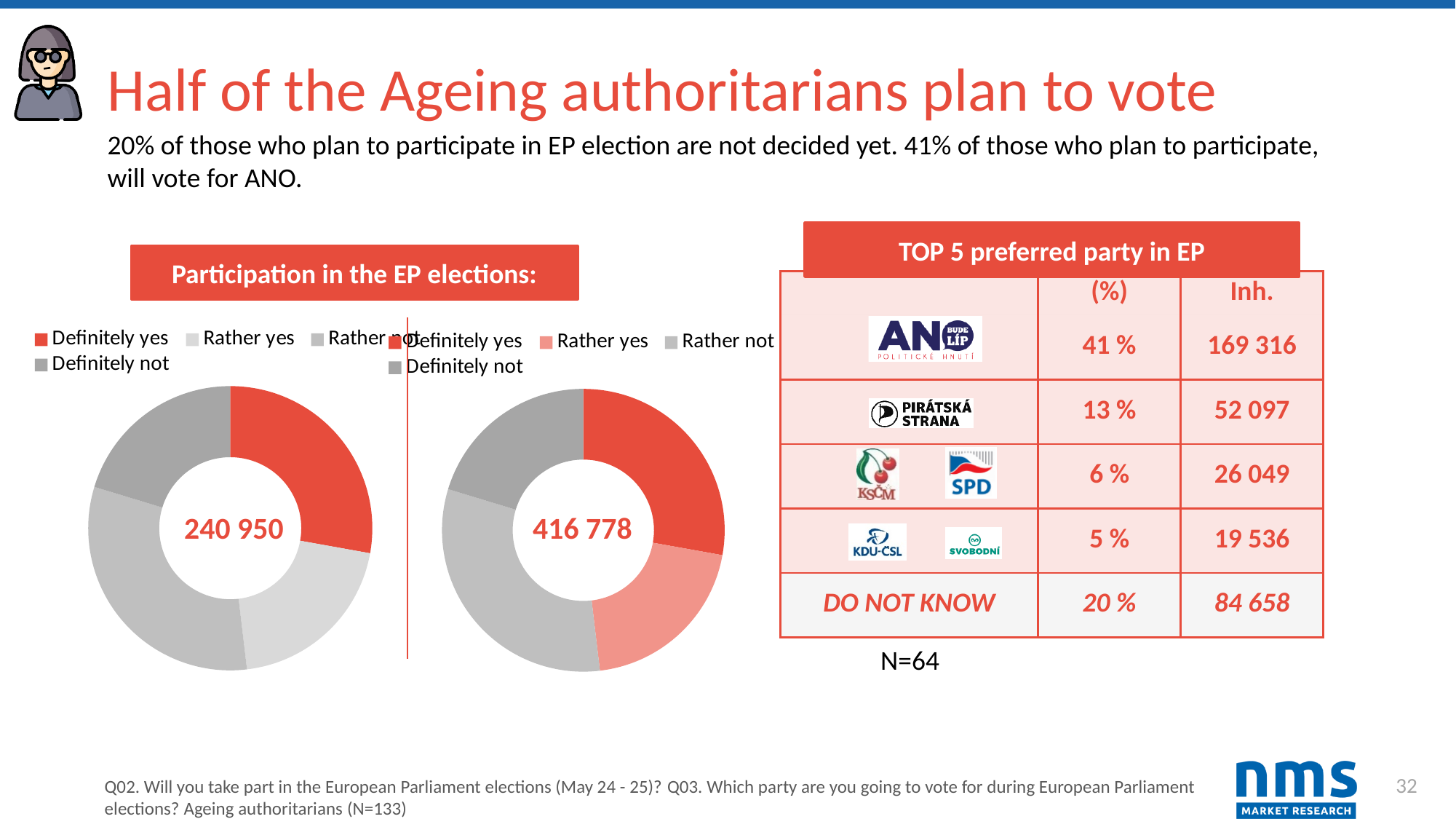
How many entries does the legend of the left donut chart list? 4 In the right donut chart, which slice is larger: 'Definitely yes' or 'Rather yes'? Definitely yes In the right donut chart, what value is printed in the centre? 416 778 How many slices does the right donut chart have? 4 In the left donut chart, which category has the largest slice? Rather not In the left donut chart, what value is printed in the centre? 240 950 What is the difference between the centre values of the right donut chart (416 778) and the left donut chart (240 950)? 175 828 Which donut chart has the larger centre value, the left one or the right one? The right one What kind of chart is used for the two 'Participation in the EP elections' charts? Donut (pie) chart What is the title shown above the two donut charts? Participation in the EP elections: What colour represents 'Definitely yes' in the donut charts? Red